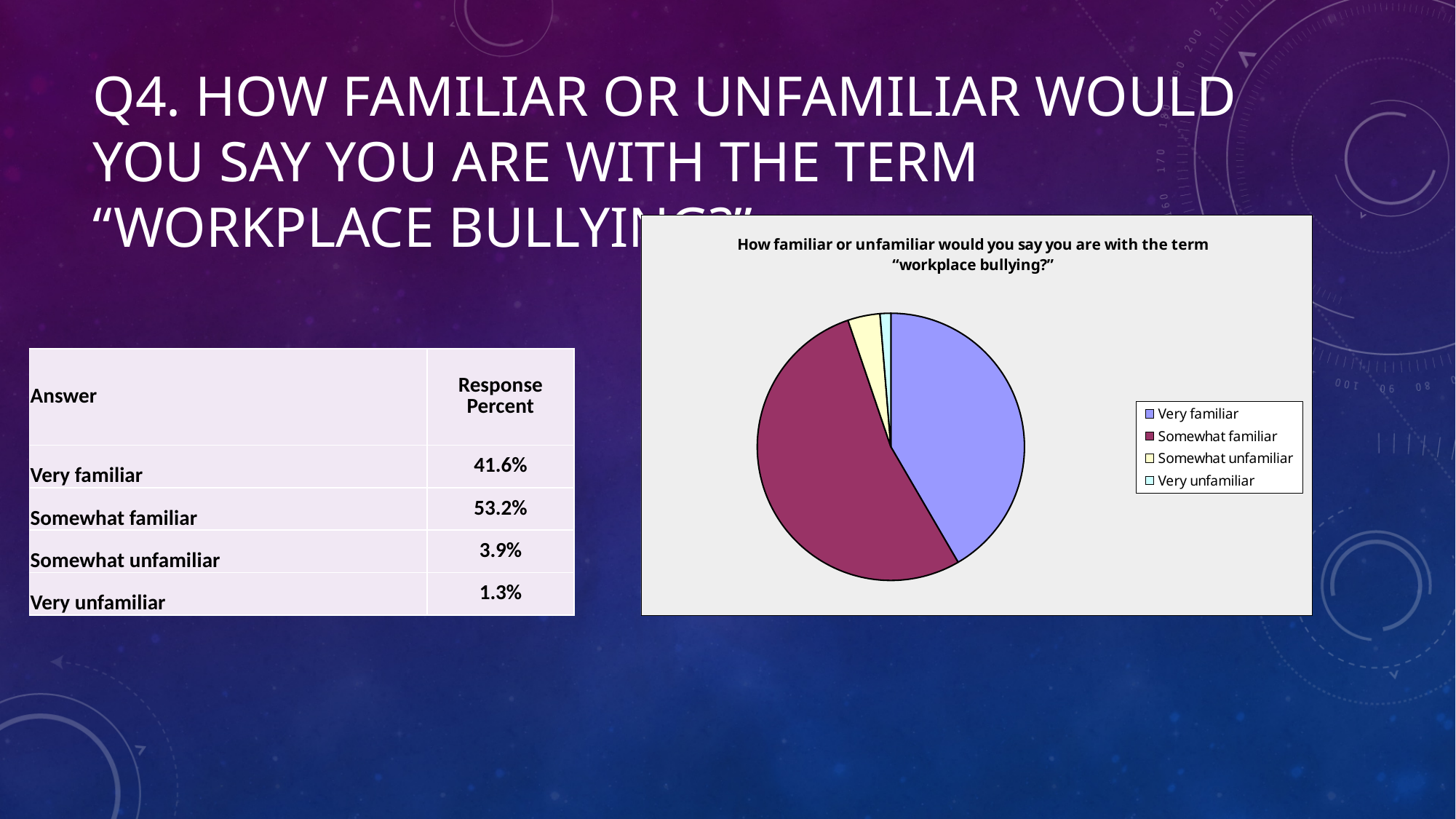
What is the difference in response percent between Somewhat familiar and Very familiar? 11.6% How many categories does the pie chart's legend list? 4 What kind of chart is shown on the slide? pie chart What is the response percent for Very familiar? 41.6% Which category has the smallest slice of the pie chart? Very unfamiliar What is the title of the pie chart? How familiar or unfamiliar would you say you are with the term "workplace bullying?" What is the response percent for Very unfamiliar? 1.3% What is the response percent for Somewhat unfamiliar? 3.9% What colour is the Somewhat familiar slice in the pie chart? dark red / maroon Which category has the largest slice of the pie chart? Somewhat familiar What is the response percent for Somewhat familiar? 53.2% Which is larger: the slice for Somewhat unfamiliar or the slice for Very unfamiliar? Somewhat unfamiliar